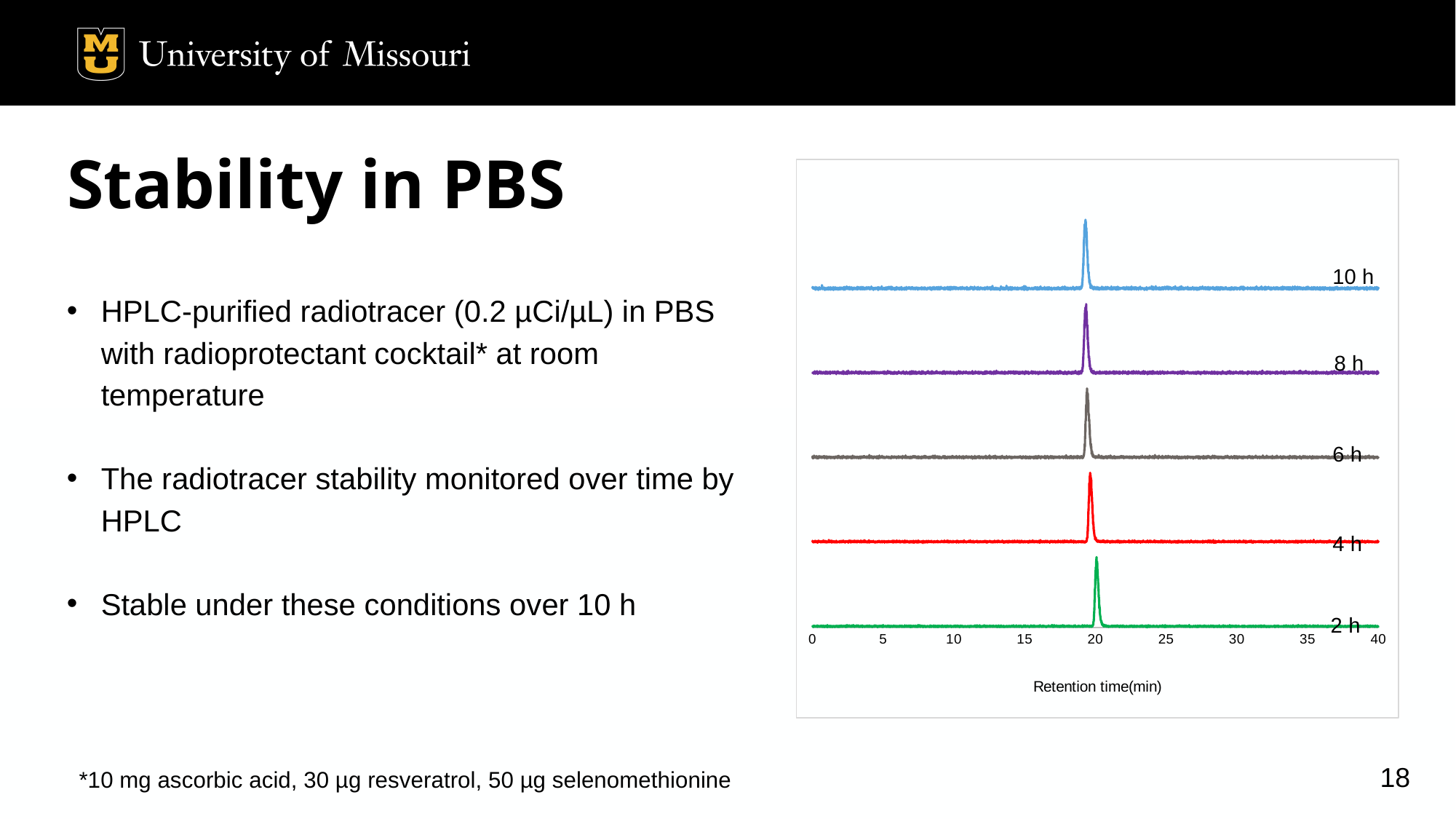
Is the retention time of the peak in the 6 h trace greater or less than 10? greater What kind of chart is shown on the slide? line chart What is the label of the x axis of the chart? Retention time(min) Is the retention time of the peak in the 2 h trace greater or less than 15? greater What is the smallest value shown on the x axis of the chart? 0 Which time point is labelled on the bottom trace of the chart? 2 h Is the retention time of the peak in the 10 h trace greater or less than 25? less What is the largest value shown on the x axis of the chart? 40 How many traces (time points) are plotted in the chart? 5 Which time point is labelled on the topmost trace of the chart? 10 h What colour is the 4 h trace in the chart? red